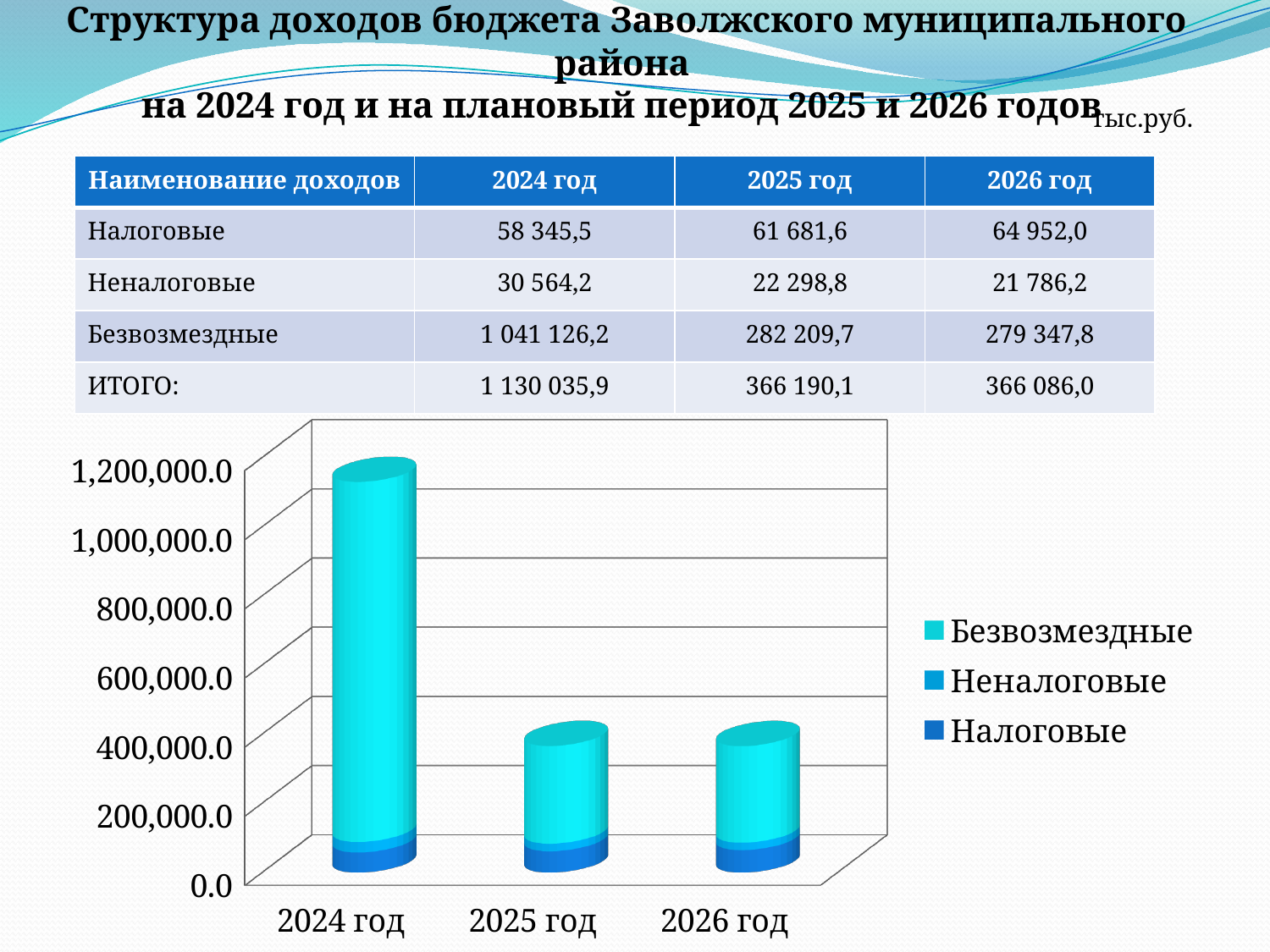
Is the total height of the bar for 2024 год greater or less than 1,000,000.0? greater Which year has the tallest stacked bar in the chart? 2024 год According to the table, what is the total (ИТОГО) for 2025 год? 366 190,1 What kind of chart is shown on the slide? bar chart Which is larger according to the table: Неналоговые for 2024 год or for 2025 год? 2024 год Do the Налоговые values rise or fall from 2024 год to 2026 год? rise Which series is listed first (at the top) in the chart legend? Безвозмездные According to the table, what is the value of Безвозмездные for 2024 год? 1 041 126,2 How many series does the chart legend list? 3 How many years (categories) are plotted on the x axis of the chart? 3 Using the table values, by how much does Налоговые in 2026 год exceed Налоговые in 2025 год? 3 270,4